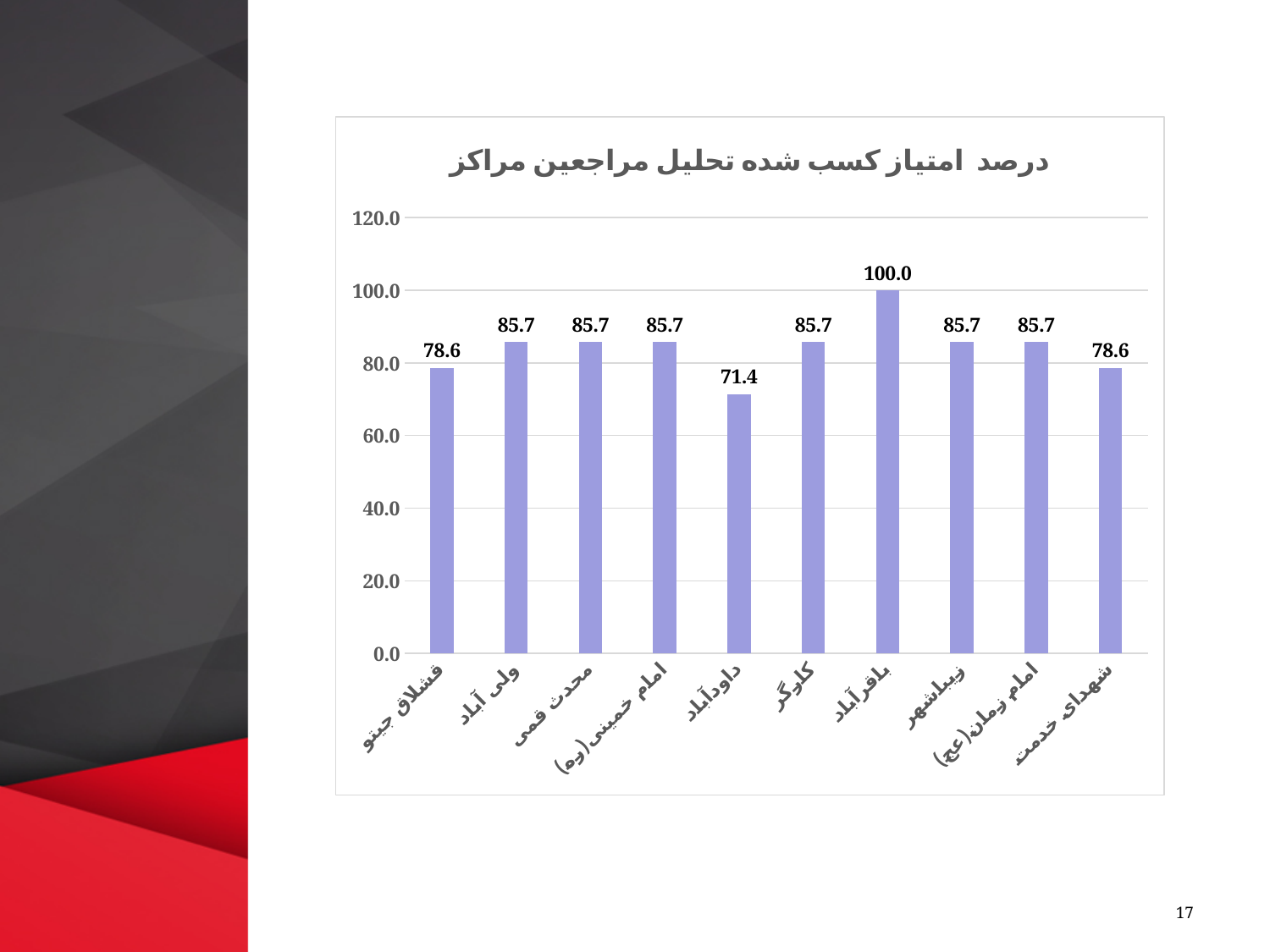
What is the value for قشلاق جیتو? 78.6 What is the difference between the values for باقرآباد and داودآباد? 28.6 Which is larger, the value for زیباشهر or the value for شهدای خدمت? زیباشهر What is the difference between the values for ولی آباد and شهدای خدمت? 7.1 What is the value for داودآباد? 71.4 Is the value for داودآباد greater or less than 80.0? less What is the value for کارگر? 85.7 Which category has the highest value? باقرآباد What kind of chart is shown on the slide? bar chart What is the value for باقرآباد? 100.0 Which category has the lowest value? داودآباد How many categories are shown on the x axis? 10